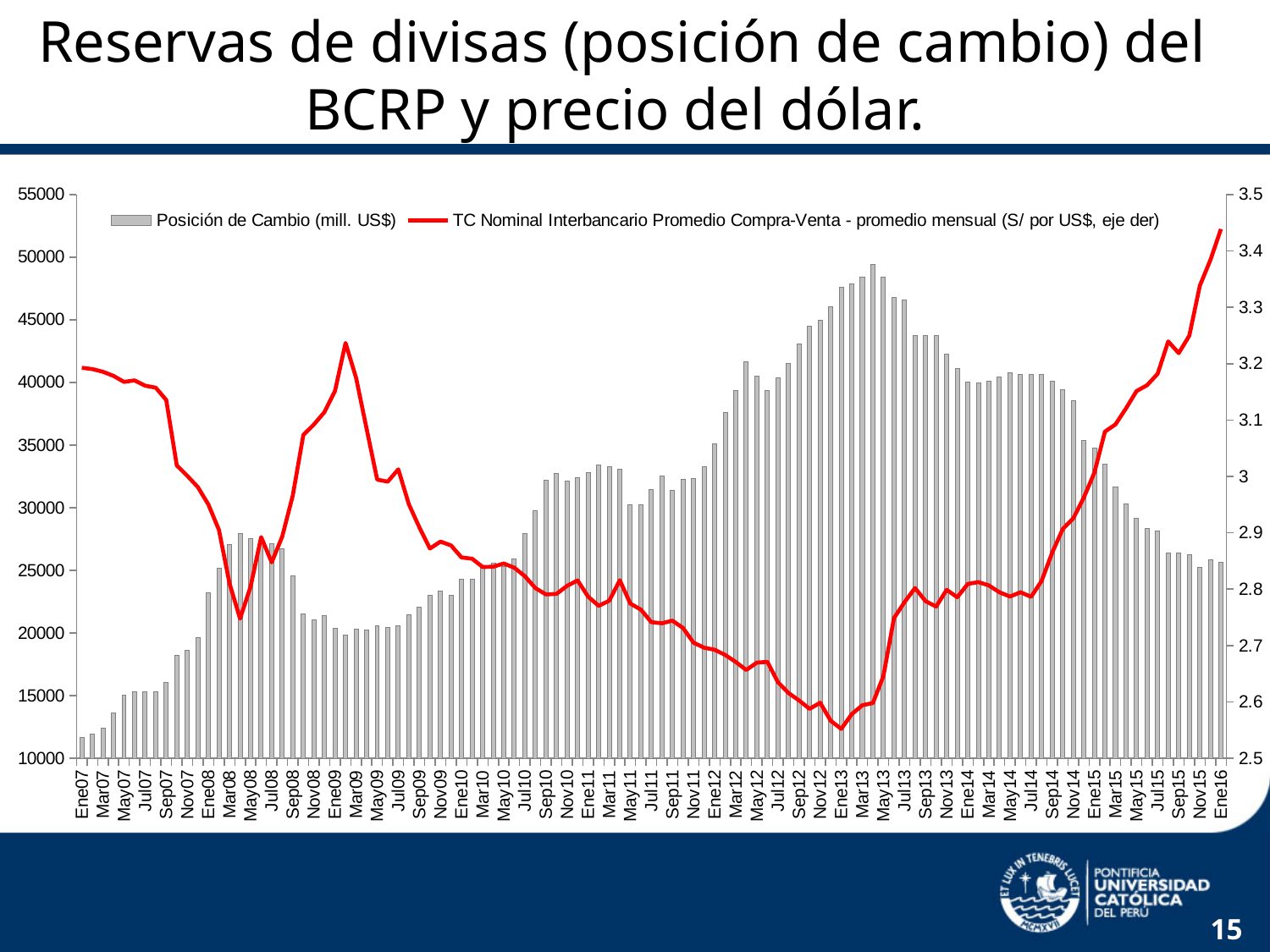
In which month is the Posición de Cambio bar the lowest? Ene07 Which is larger, the Posición de Cambio for Ene08 or for Ene12? Ene12 Is the TC Nominal Interbancario value for Ene16 greater or less than 3.4? greater What kind of chart is shown on the slide? A combined bar and line chart How many series does the legend list? 2 In which month does the TC Nominal Interbancario line reach its highest value? Ene16 Is the Posición de Cambio value for Mar13 greater or less than 45000? greater Does the TC Nominal Interbancario line rise or fall between Ene13 and Ene16? rise Is the TC Nominal Interbancario value for Ene13 greater or less than 2.6? less Which series is plotted as bars? Posición de Cambio (mill. US$) What is the title of the slide's chart? Reservas de divisas (posición de cambio) del BCRP y precio del dólar.